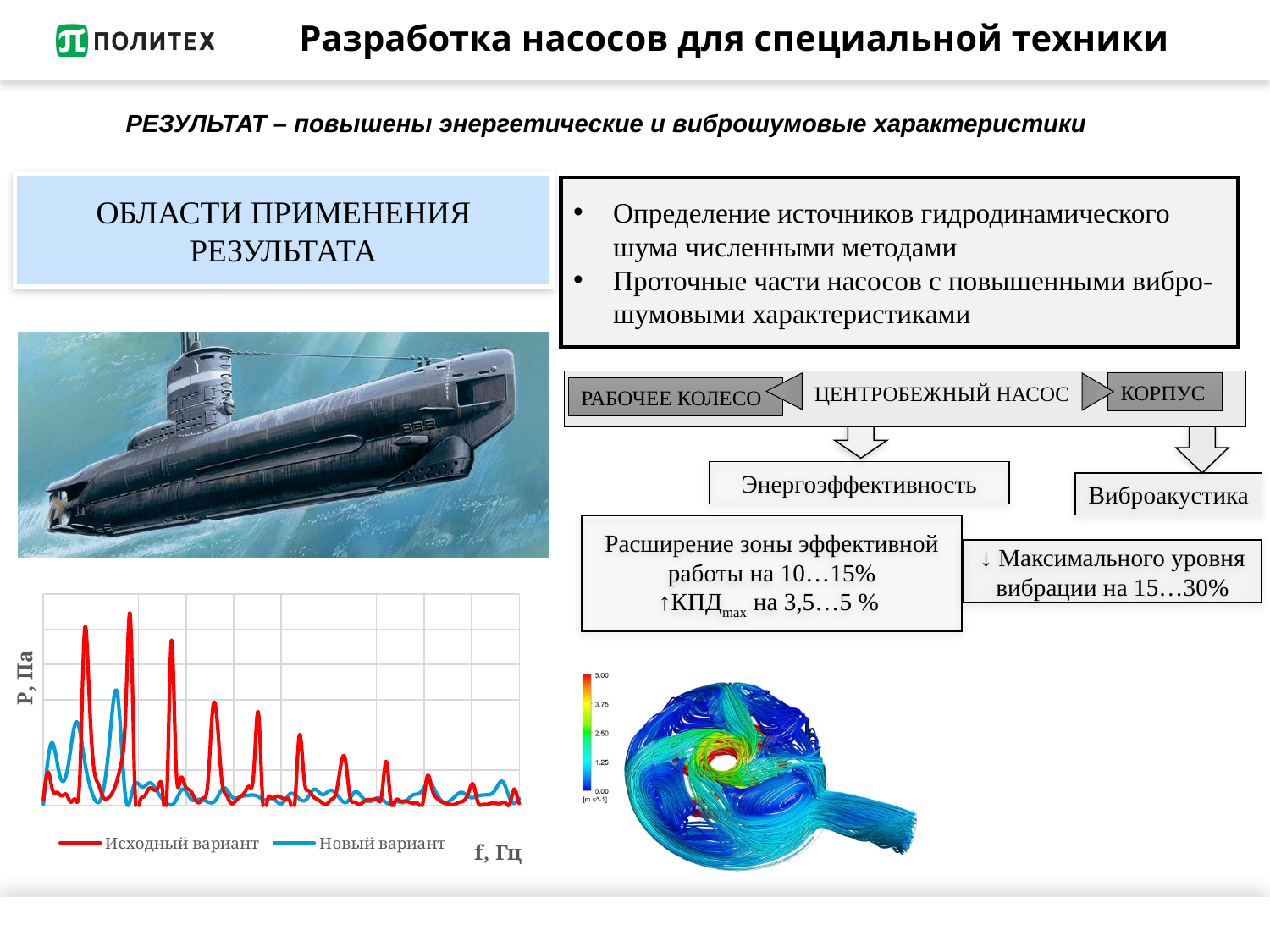
What kind of chart is shown at the bottom left of the slide? line chart How many series does the legend of the bottom-left chart list? 2 What label is shown on the vertical axis of the bottom-left chart? P, Па In the bottom-left chart, which series reaches the higher peak value, Исходный вариант or Новый вариант? Исходный вариант In the bottom-left chart, do the peaks of the Исходный вариант series generally rise or fall along the x axis? fall In the bottom-left chart, which series has the lower overall peak values? Новый вариант What colour is the Новый вариант series in the bottom-left chart? blue